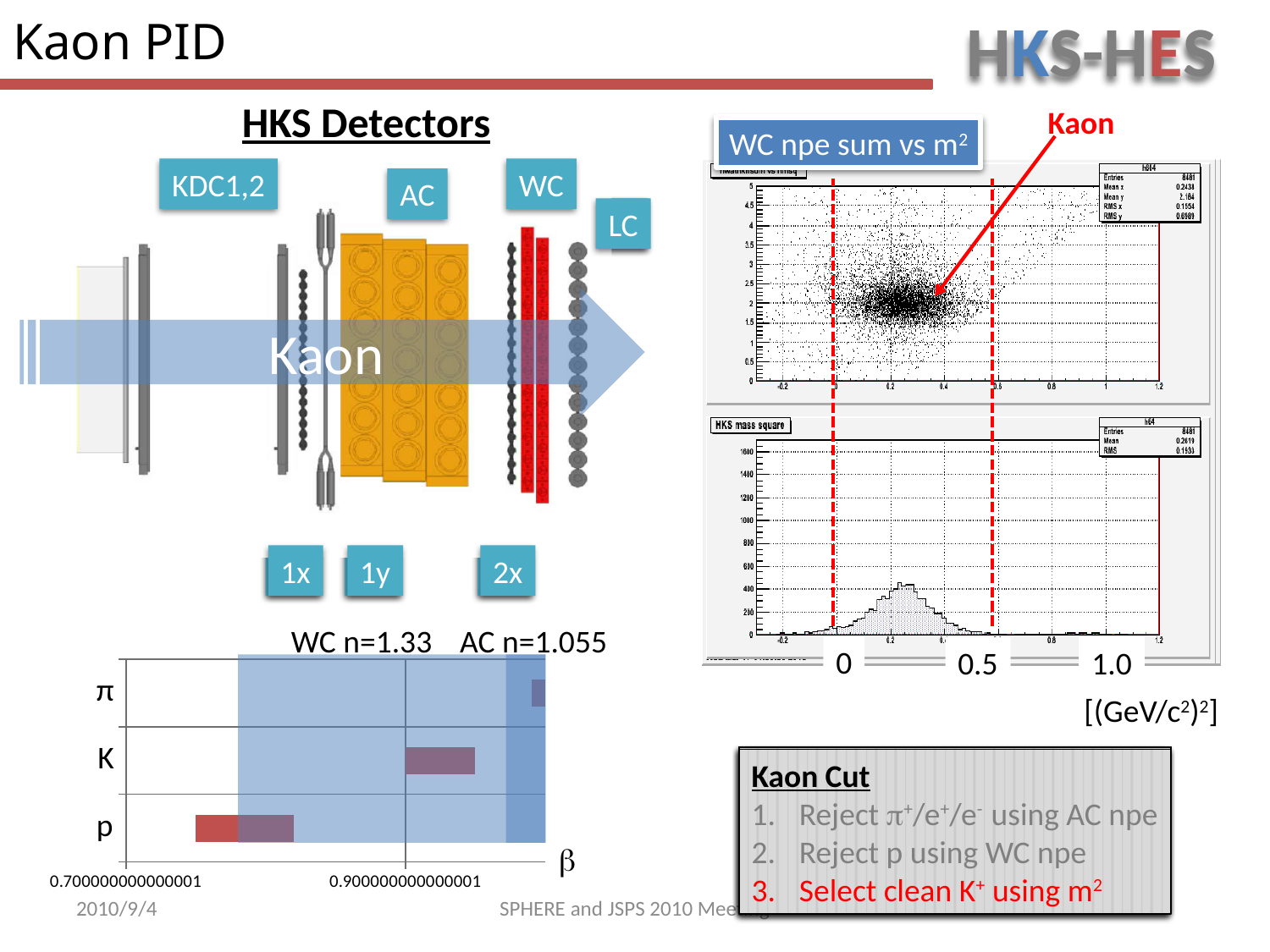
What is the title of the upper scatter plot on the right side of the slide? WC npe sum vs m² How many particle categories are shown on the y axis of the bottom-left β chart? 3 What quantity is labelled on the horizontal axis of the bottom-left bar chart? β In the bottom-left β chart, is the β value for π greater or less than 0.9? greater In the bottom-left β chart, which particle category has the bar at the highest β? π In the bottom-left β chart, which has the larger β value, K or p? K In the bottom-left β chart, is the β value for p greater or less than 0.9? less In the HKS mass square histogram on the right, is the peak of the distribution at a mass squared greater or less than 0.5? less In the bottom-left β chart, which particle category has the bar at the lowest β? p What kind of chart is the plot at the bottom left with the β axis? bar chart